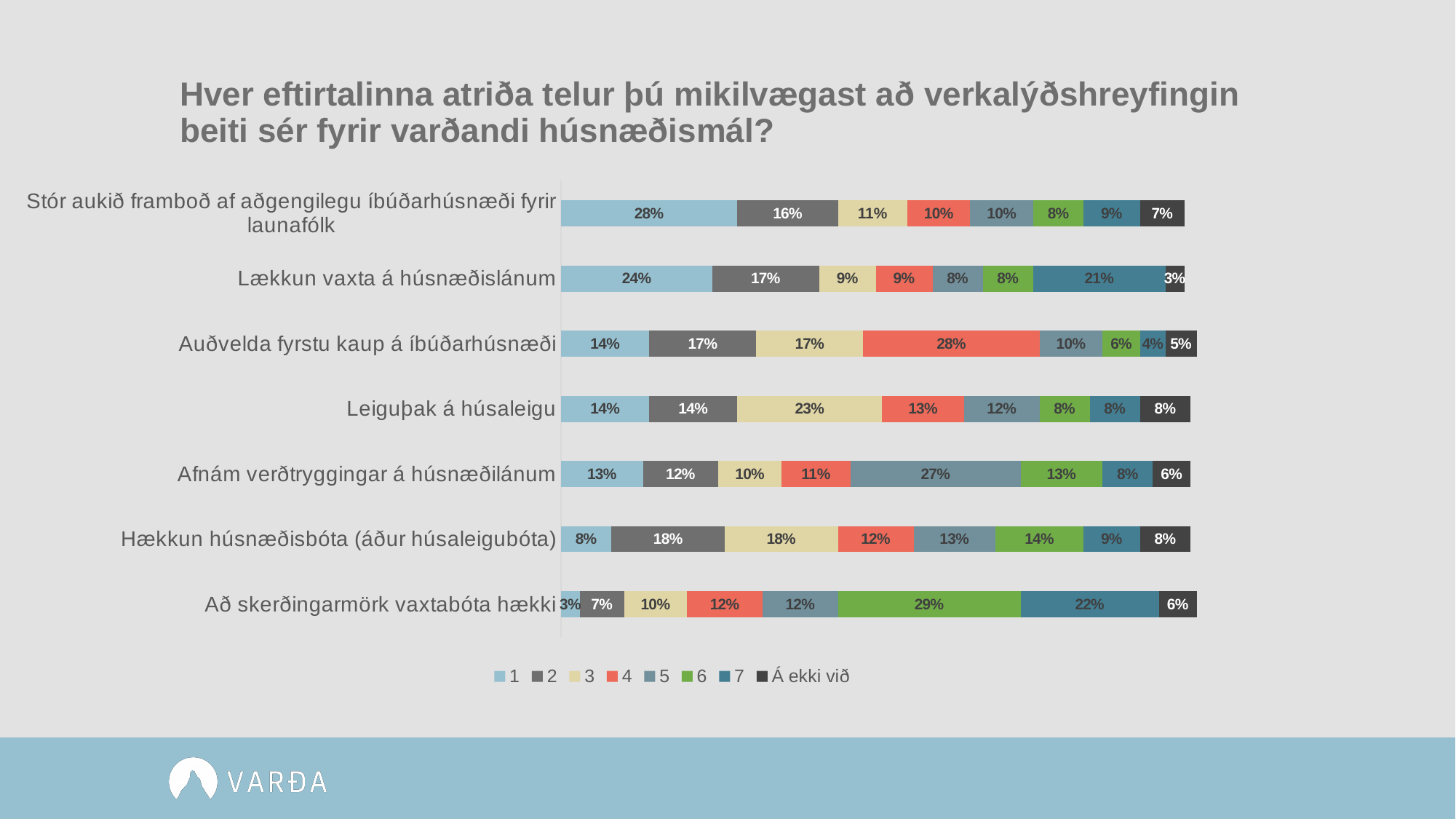
What is the value for series 4 for "Auðvelda fyrstu kaup á íbúðarhúsnæði"? 28% What is the value for series 6 for "Að skerðingarmörk vaxtabóta hækki"? 29% Which category has the highest value for series 1? Stór aukið framboð af aðgengilegu íbúðarhúsnæði fyrir launafólk What is the value for series 1 for "Lækkun vaxta á húsnæðislánum"? 24% What kind of chart is shown on the slide? Stacked bar chart Which is larger: the series 5 value for "Afnám verðtryggingar á húsnæðilánum" or the series 5 value for "Hækkun húsnæðisbóta (áður húsaleigubóta)"? Afnám verðtryggingar á húsnæðilánum Which category has the lowest value for series 1? Að skerðingarmörk vaxtabóta hækki What is the total of the stacked bar for "Leiguþak á húsaleigu"? 100% How many categories (housing issues) are plotted on the chart? 7 How many series does the legend list? 8 What is the difference between the series 7 value for "Lækkun vaxta á húsnæðislánum" and the series 7 value for "Stór aukið framboð af aðgengilegu íbúðarhúsnæði fyrir launafólk"? 12% What is the "Á ekki við" value for "Leiguþak á húsaleigu"? 8%